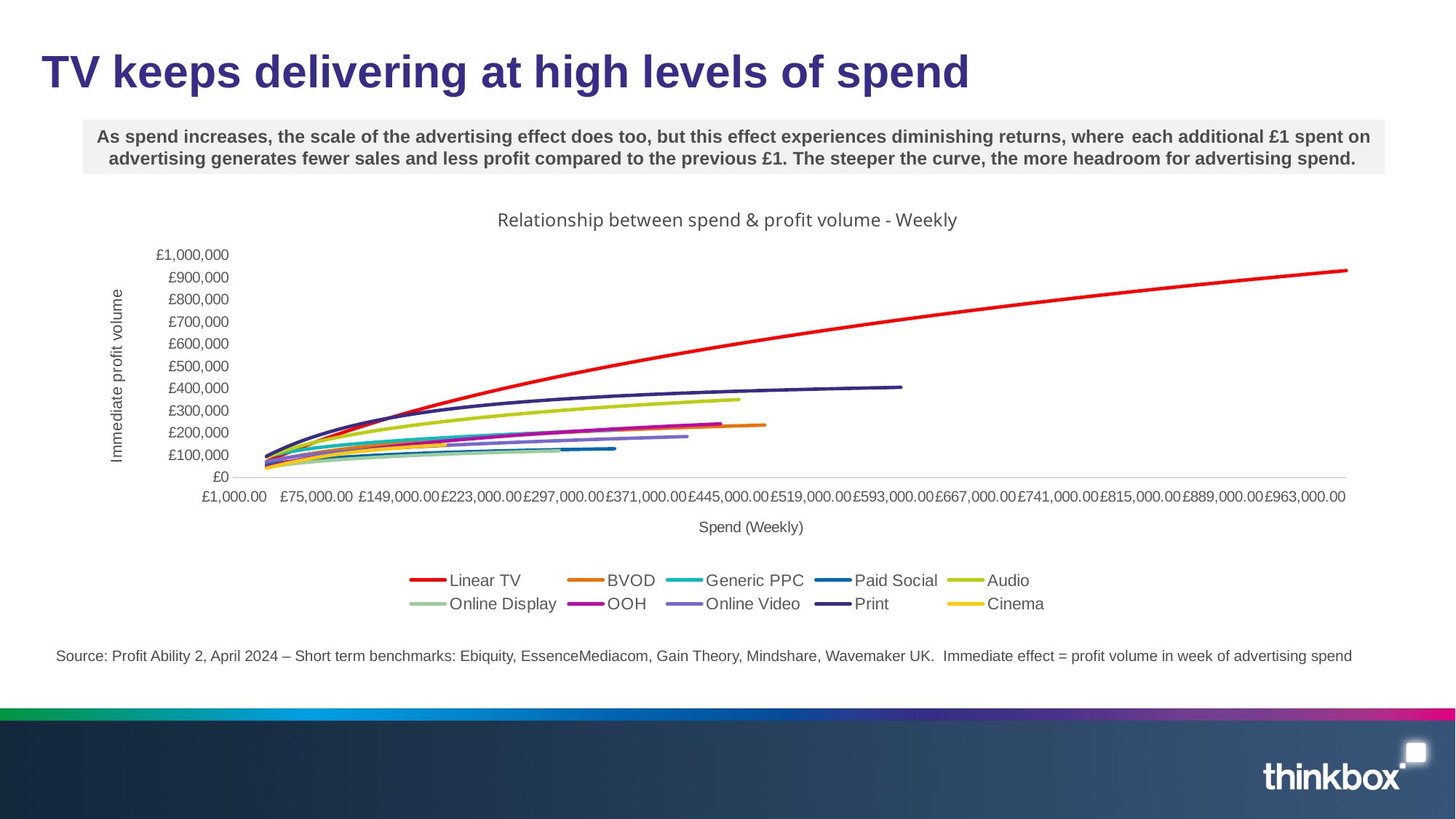
Is the highest value reached by the Online Display curve greater or less than £200,000? less Which curve reaches a higher immediate profit volume at its end point, Linear TV or Print? Linear TV Does immediate profit volume rise or fall as weekly spend increases along the x axis? Rise Is the highest value reached by the Audio curve greater or less than £300,000? greater How many series does the legend list? 10 Which series reaches the highest immediate profit volume? Linear TV What kind of chart is shown on the slide? Line chart What is the title of the chart? Relationship between spend & profit volume - Weekly Is the highest value reached by the Print curve greater or less than £500,000? less Which curve reaches a higher immediate profit volume at its end point, Audio or Online Video? Audio What is the label of the vertical axis? Immediate profit volume